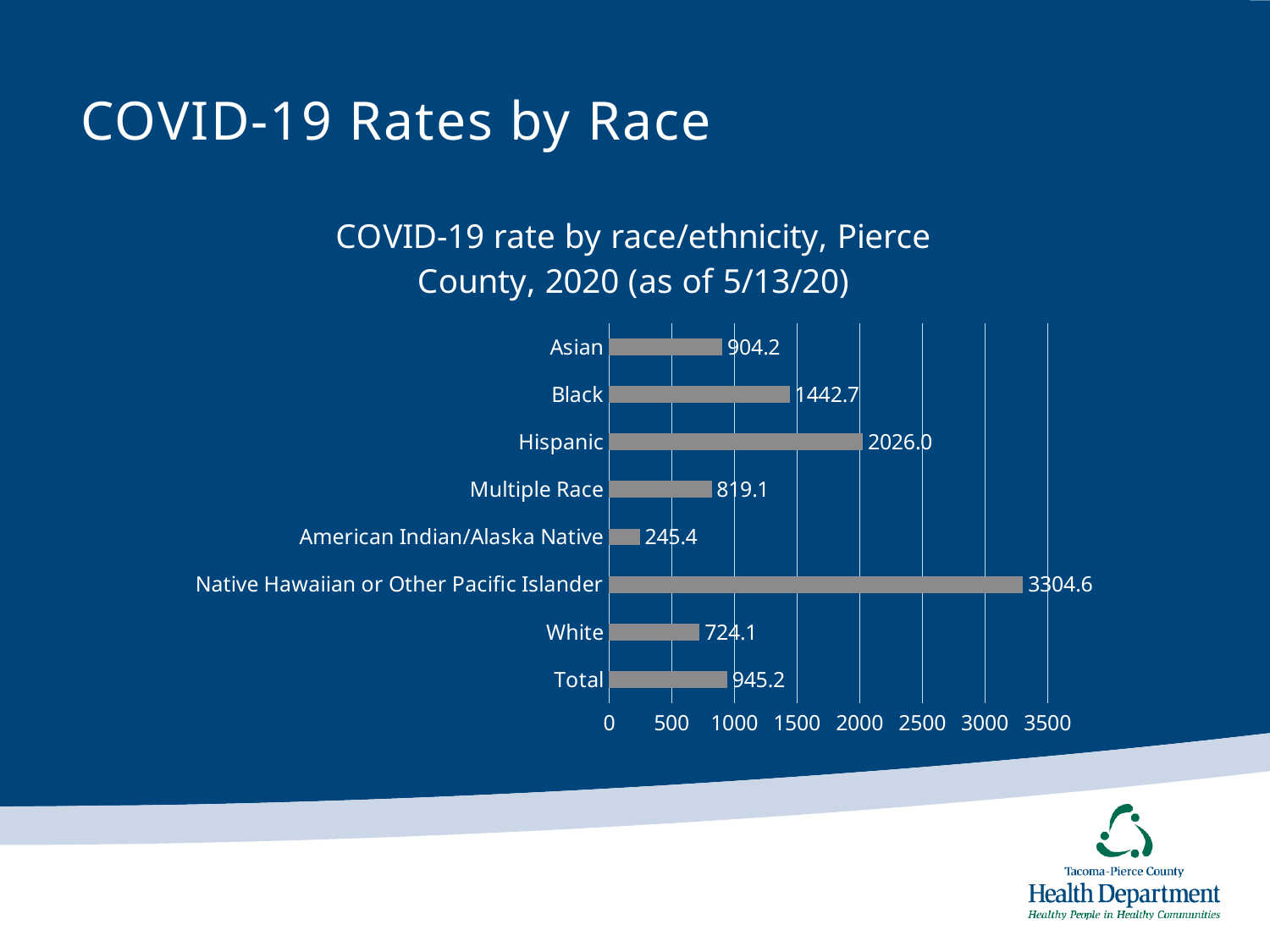
What is the Total COVID-19 rate shown on the chart? 945.2 What kind of chart is shown on the slide? Bar chart What is the difference between the Hispanic rate and the Black rate? 583.3 What is the COVID-19 rate for White residents? 724.1 Is the value for Hispanic greater or less than 2000? greater Which is larger, the rate for Asian residents or the rate for Multiple Race residents? Asian What is the COVID-19 rate for Black residents? 1442.7 What is the title of the chart? COVID-19 rate by race/ethnicity, Pierce County, 2020 (as of 5/13/20) Which race/ethnicity category has the lowest COVID-19 rate? American Indian/Alaska Native What is the COVID-19 rate for Native Hawaiian or Other Pacific Islander residents? 3304.6 Which race/ethnicity category has the highest COVID-19 rate? Native Hawaiian or Other Pacific Islander How many categories are plotted on the chart? 8